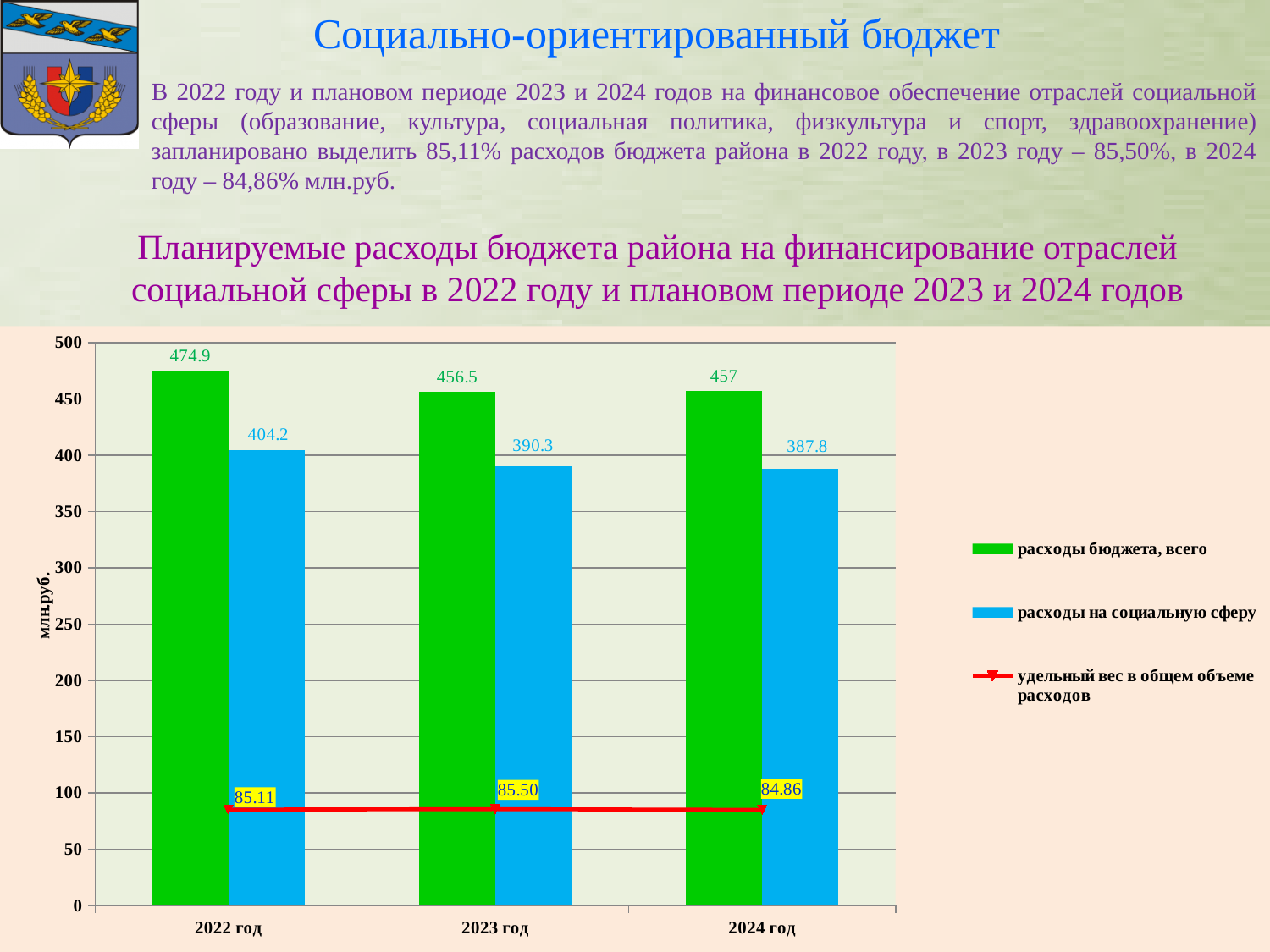
What is the difference between 'расходы бюджета, всего' and 'расходы на социальную сферу' in 2022 год? 70.7 What kind of chart is shown on the slide? combination bar and line chart Which is larger: 'расходы на социальную сферу' in 2022 год or in 2023 год? 2022 год How many series does the legend list? 3 Do the values of 'расходы на социальную сферу' rise or fall from 2022 год to 2024 год? fall Is the value of 'расходы бюджета, всего' for 2023 год greater or less than 450? greater What is the value of 'расходы бюджета, всего' for 2022 год? 474.9 What is the value of 'удельный вес в общем объеме расходов' for 2023 год? 85.50 How many years are shown on the x axis? 3 What is the value of 'расходы на социальную сферу' for 2024 год? 387.8 In which year is 'расходы на социальную сферу' the lowest? 2024 год In which year is 'расходы бюджета, всего' the highest? 2022 год